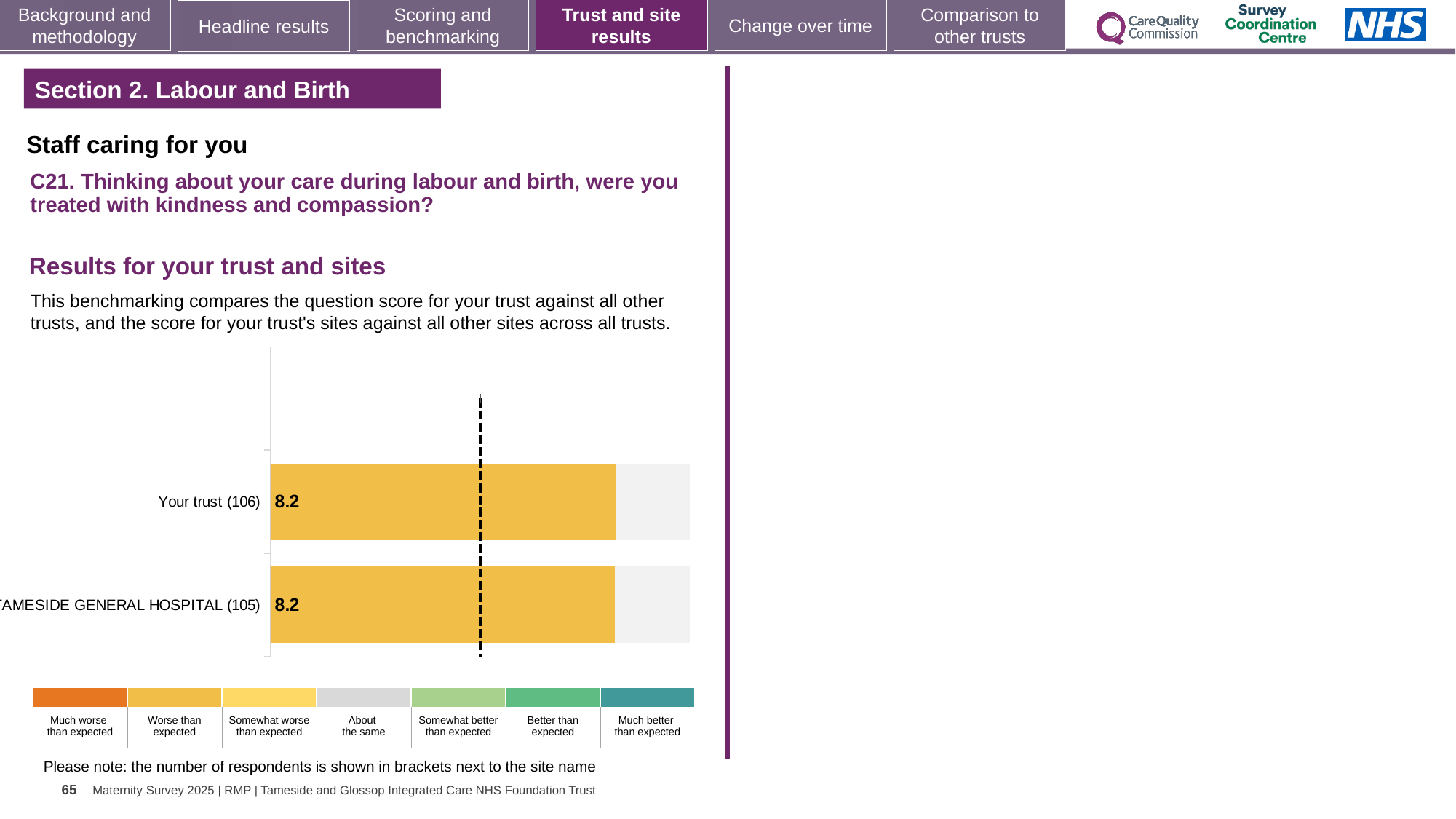
What is the score for Tameside General Hospital? 8.2 Which survey question does the chart relate to? C21. Thinking about your care during labour and birth, were you treated with kindness and compassion? Is the score for Your trust the same as the score for Tameside General Hospital? Yes How many bars are plotted in the chart? 2 How many respondents are shown in brackets for Tameside General Hospital? 105 What is the score for Your trust? 8.2 How many benchmark categories are shown in the colour key below the chart? 7 What is the difference between the score for Your trust and the score for Tameside General Hospital? 0 What kind of chart is shown on the slide? Bar chart How many respondents are shown in brackets for Your trust? 106